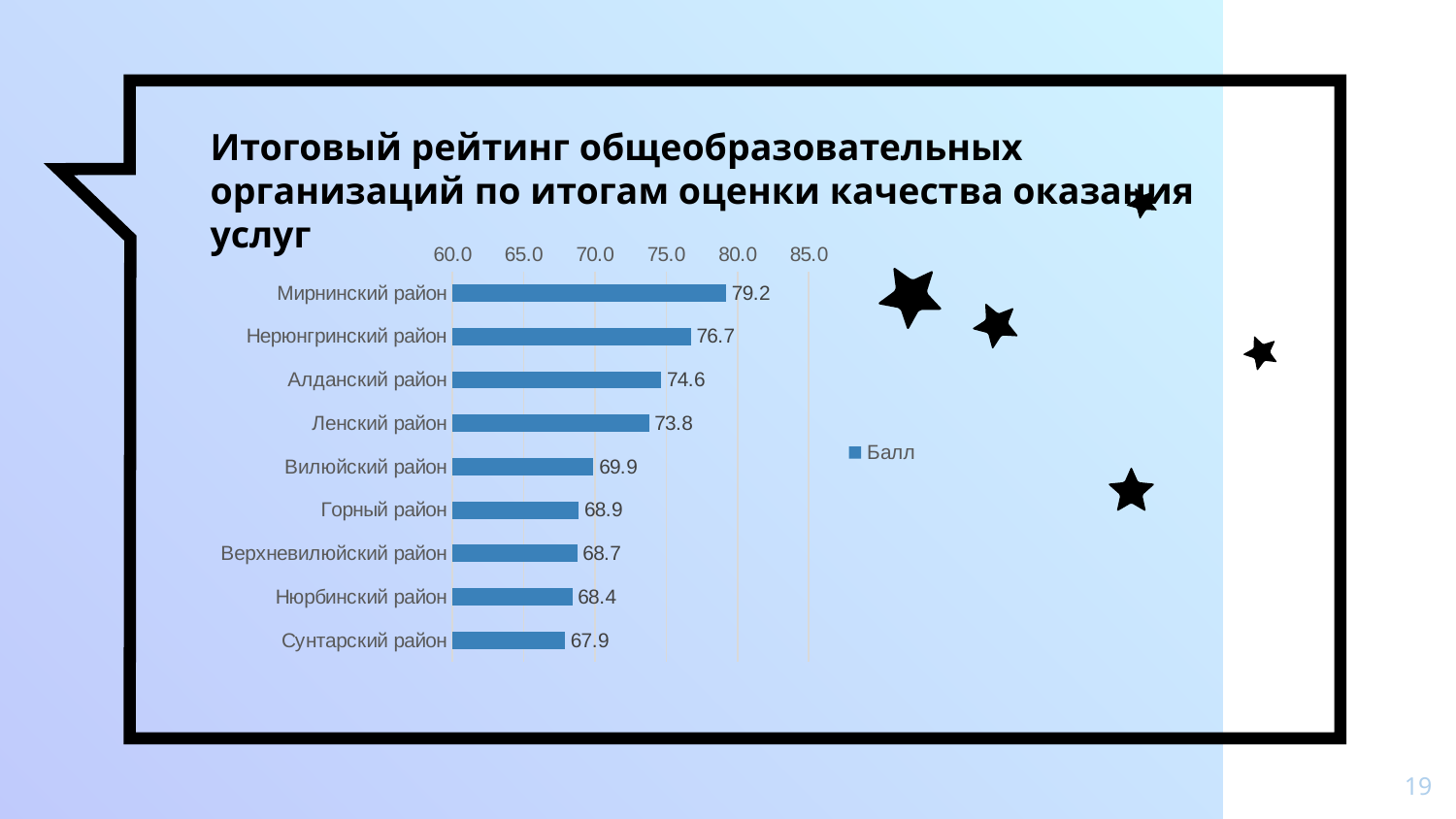
What kind of chart is shown on the slide? bar chart How many series does the legend list? 1 What is the legend entry for the series in the chart? Балл Which district has the lowest score? Сунтарский район Which is larger, the value for Алданский район or the value for Вилюйский район? Алданский район Which district has the highest score? Мирнинский район Is the value for Нерюнгринский район greater or less than 75.0? greater What is the value for Ленский район? 73.8 What is the difference between the values for Мирнинский район and Нерюнгринский район? 2.5 What is the value for Сунтарский район? 67.9 What is the value for Мирнинский район? 79.2 How many districts are shown in the chart? 9